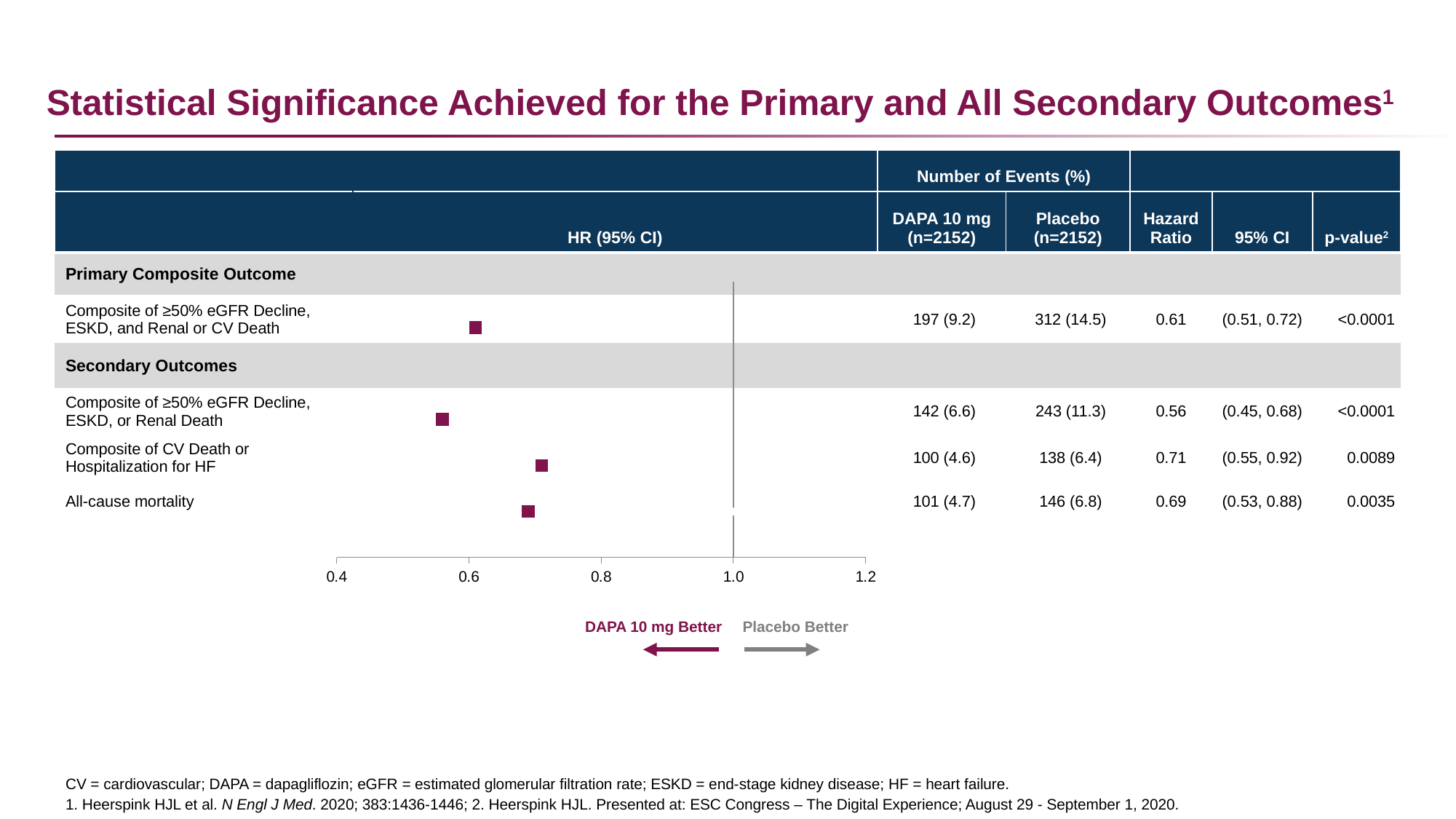
Which outcome has the lowest hazard ratio? Composite of ≥50% eGFR Decline, ESKD, or Renal Death What is the difference between the hazard ratio for the Composite of CV Death or Hospitalization for HF and the hazard ratio for the Composite of ≥50% eGFR Decline, ESKD, or Renal Death? 0.15 What is the 95% CI for the Composite of CV Death or Hospitalization for HF? (0.55, 0.92) How many outcomes are plotted as points on the chart? 4 Which outcome has the highest hazard ratio? Composite of CV Death or Hospitalization for HF What label is shown next to the left-pointing arrow below the x axis? DAPA 10 mg Better What is the hazard ratio for the Composite of ≥50% eGFR Decline, ESKD, and Renal or CV Death? 0.61 What is the p-value for the Composite of CV Death or Hospitalization for HF? 0.0089 Is the hazard ratio for All-cause mortality greater or less than 1.0? less What is the hazard ratio for All-cause mortality? 0.69 What kind of chart is shown on the slide? forest plot Which has the larger hazard ratio: All-cause mortality or the Composite of ≥50% eGFR Decline, ESKD, or Renal Death? All-cause mortality